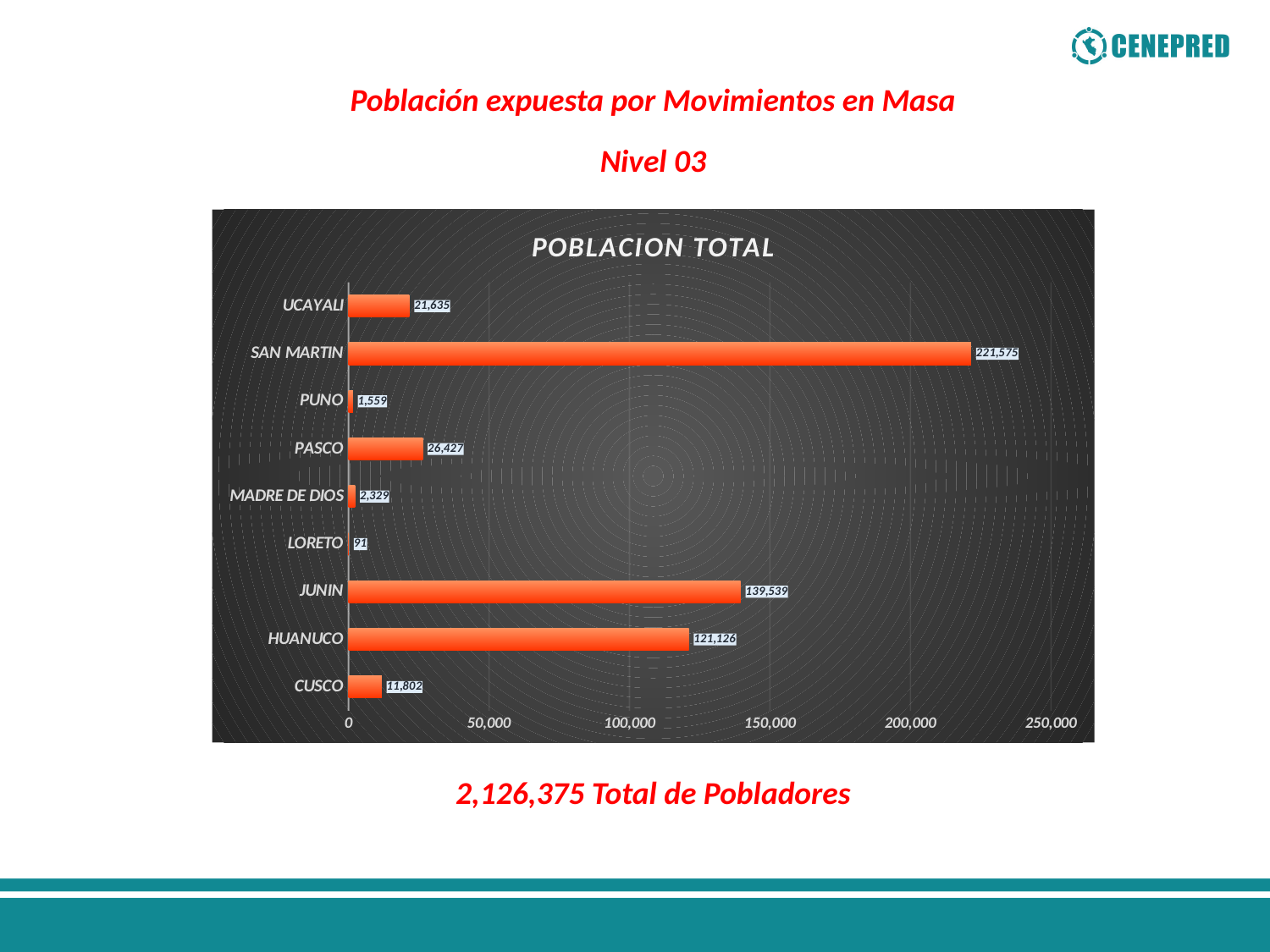
Which is larger in the POBLACION TOTAL chart, the value for UCAYALI or the value for CUSCO? UCAYALI What is the value for PASCO in the POBLACION TOTAL chart? 26,427 What is the value for SAN MARTIN in the POBLACION TOTAL chart? 221,575 What kind of chart is the POBLACION TOTAL chart? bar chart Which category has the highest value in the POBLACION TOTAL chart? SAN MARTIN What is the value for JUNIN in the POBLACION TOTAL chart? 139,539 How many categories are shown in the POBLACION TOTAL chart? 9 Is the value for HUANUCO in the POBLACION TOTAL chart greater or less than 100,000? greater What is the difference between the values for JUNIN and HUANUCO in the POBLACION TOTAL chart? 18,413 What is the title of the chart on the slide? POBLACION TOTAL What is the value for LORETO in the POBLACION TOTAL chart? 91 Which category has the lowest value in the POBLACION TOTAL chart? LORETO